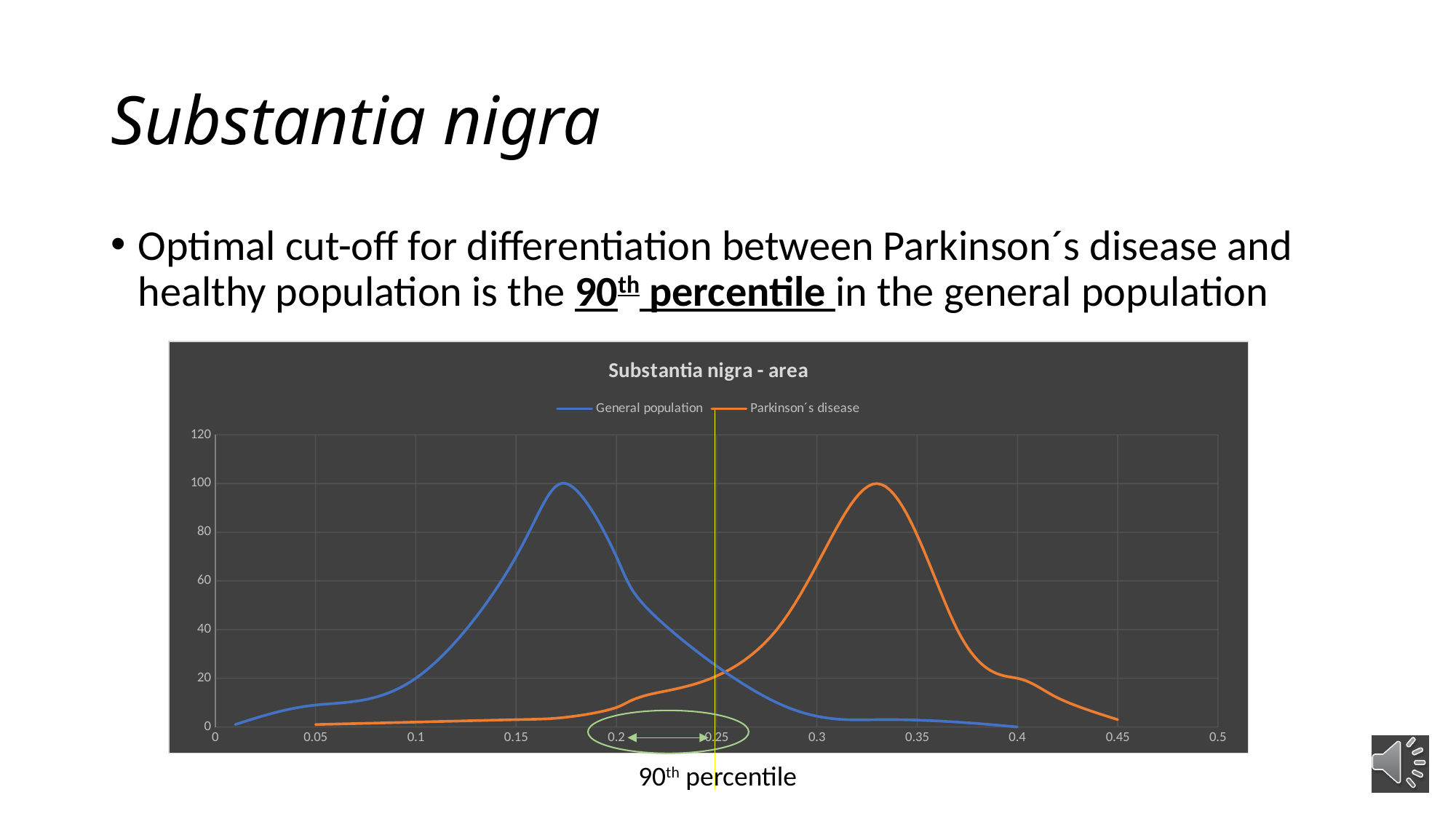
At which x-axis value is the vertical yellow line marking the 90th percentile drawn? 0.25 Is the value for Parkinson´s disease at x = 0.1 greater or less than 20? less What kind of chart is shown on the slide? line chart Is the value for General population at x = 0.2 greater or less than 40? greater Does the General population curve rise or fall between x = 0.2 and x = 0.4? fall Does the Parkinson´s disease curve rise or fall between x = 0.2 and x = 0.3? rise How many series does the legend of the chart list? 2 At x = 0.35, which series has the higher value, General population or Parkinson´s disease? Parkinson´s disease At x = 0.15, which series has the higher value, General population or Parkinson´s disease? General population Is the value for General population at x = 0.1 greater or less than 40? less What is the title of the chart? Substantia nigra - area